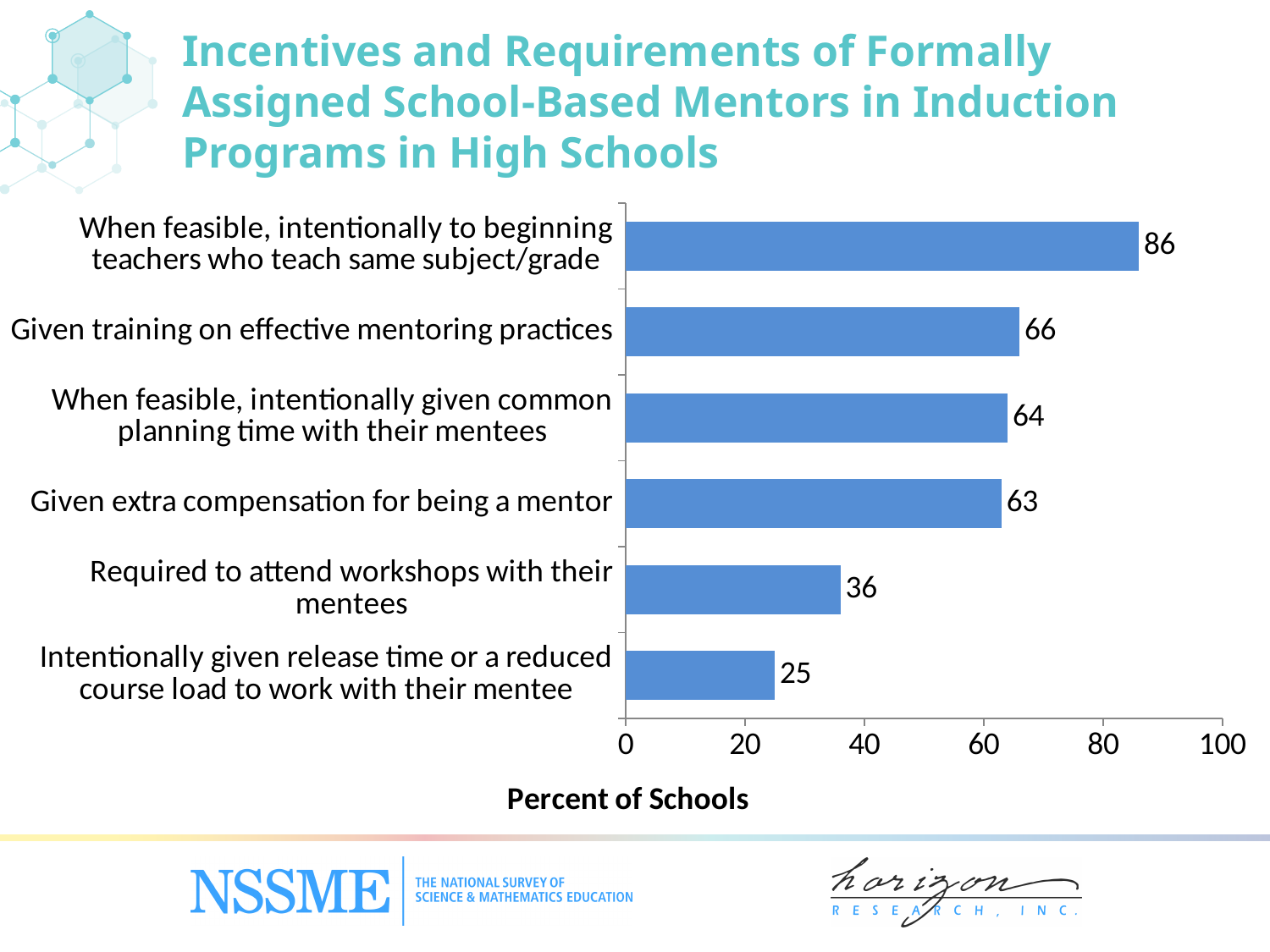
What is the label of the horizontal axis? Percent of Schools What percent of schools report that mentors are given extra compensation for being a mentor? 63 Which is larger: the value for 'Given training on effective mentoring practices' or the value for 'Required to attend workshops with their mentees'? Given training on effective mentoring practices Which category has the lowest value? Intentionally given release time or a reduced course load to work with their mentee What kind of chart is shown on the slide? bar chart How many categories are shown in the chart? 6 Which category has the highest value? When feasible, intentionally to beginning teachers who teach same subject/grade Is the value for 'When feasible, intentionally given common planning time with their mentees' greater or less than 60? greater What is the value for 'Intentionally given release time or a reduced course load to work with their mentee'? 25 What is the difference between the value for 'Required to attend workshops with their mentees' and the value for 'Intentionally given release time or a reduced course load to work with their mentee'? 11 What percent of schools report that mentors are given training on effective mentoring practices? 66 What is the difference between the value for 'When feasible, intentionally to beginning teachers who teach same subject/grade' and the value for 'Required to attend workshops with their mentees'? 50